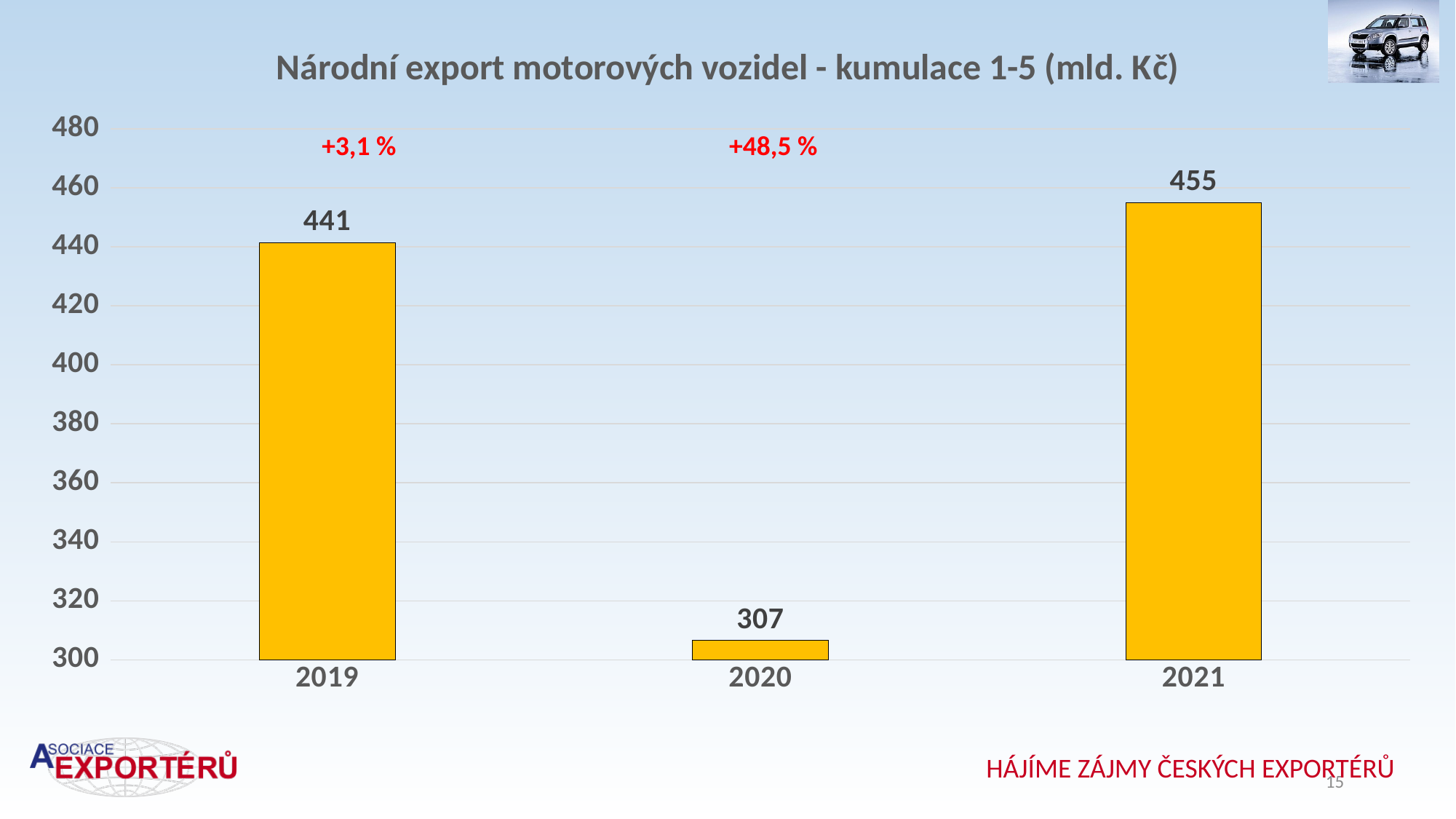
What is the difference between the values for 2021 and 2019? 14 Which is larger, the value for 2019 or the value for 2020? 2019 What is the value for 2019? 441 What is the value for 2020? 307 What kind of chart is shown on the slide? bar chart Which year has the lowest value? 2020 Is the value for 2020 greater or less than 320? less What is the difference between the values for 2021 and 2020? 148 What is the title of the chart? Národní export motorových vozidel - kumulace 1-5 (mld. Kč) What is the value for 2021? 455 How many years are shown on the chart? 3 Which year has the highest value? 2021